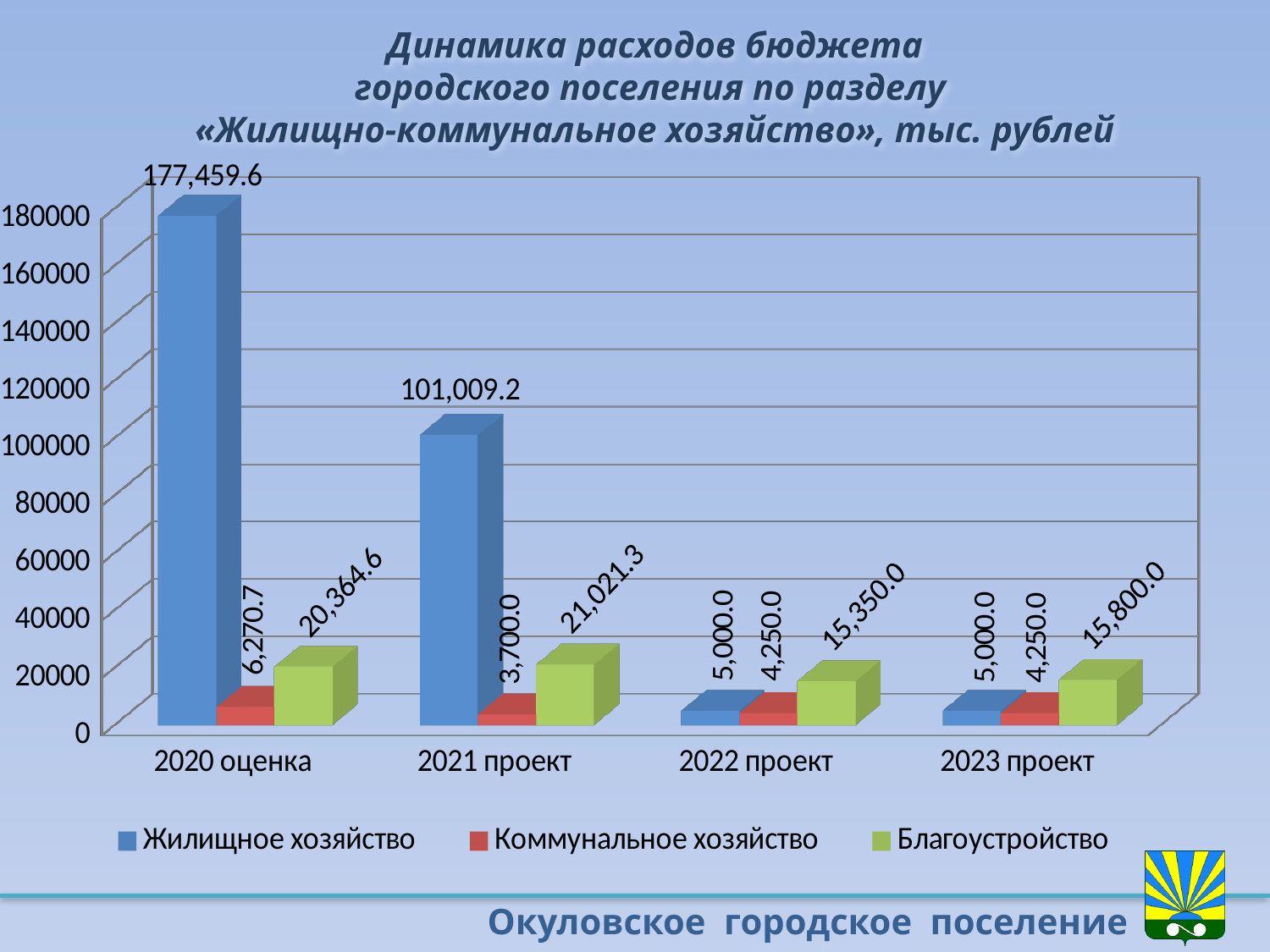
What kind of chart is shown on the slide? Bar chart Does the value for Жилищное хозяйство rise or fall from 2020 оценка to 2022 проект? Fall What is the value for Благоустройство in 2023 проект? 15,800.0 Which is larger: Благоустройство in 2020 оценка or Благоустройство in 2021 проект? Благоустройство in 2021 проект What is the value for Благоустройство in 2021 проект? 21,021.3 What is the value for Коммунальное хозяйство in 2022 проект? 4,250.0 What is the difference between the Жилищное хозяйство values for 2020 оценка and 2021 проект? 76,450.4 In which category is the value for Жилищное хозяйство highest? 2020 оценка What is the value for Жилищное хозяйство in 2020 оценка? 177,459.6 How many series does the legend list? 3 In which category is the value for Благоустройство lowest? 2022 проект How many categories are shown on the x axis? 4